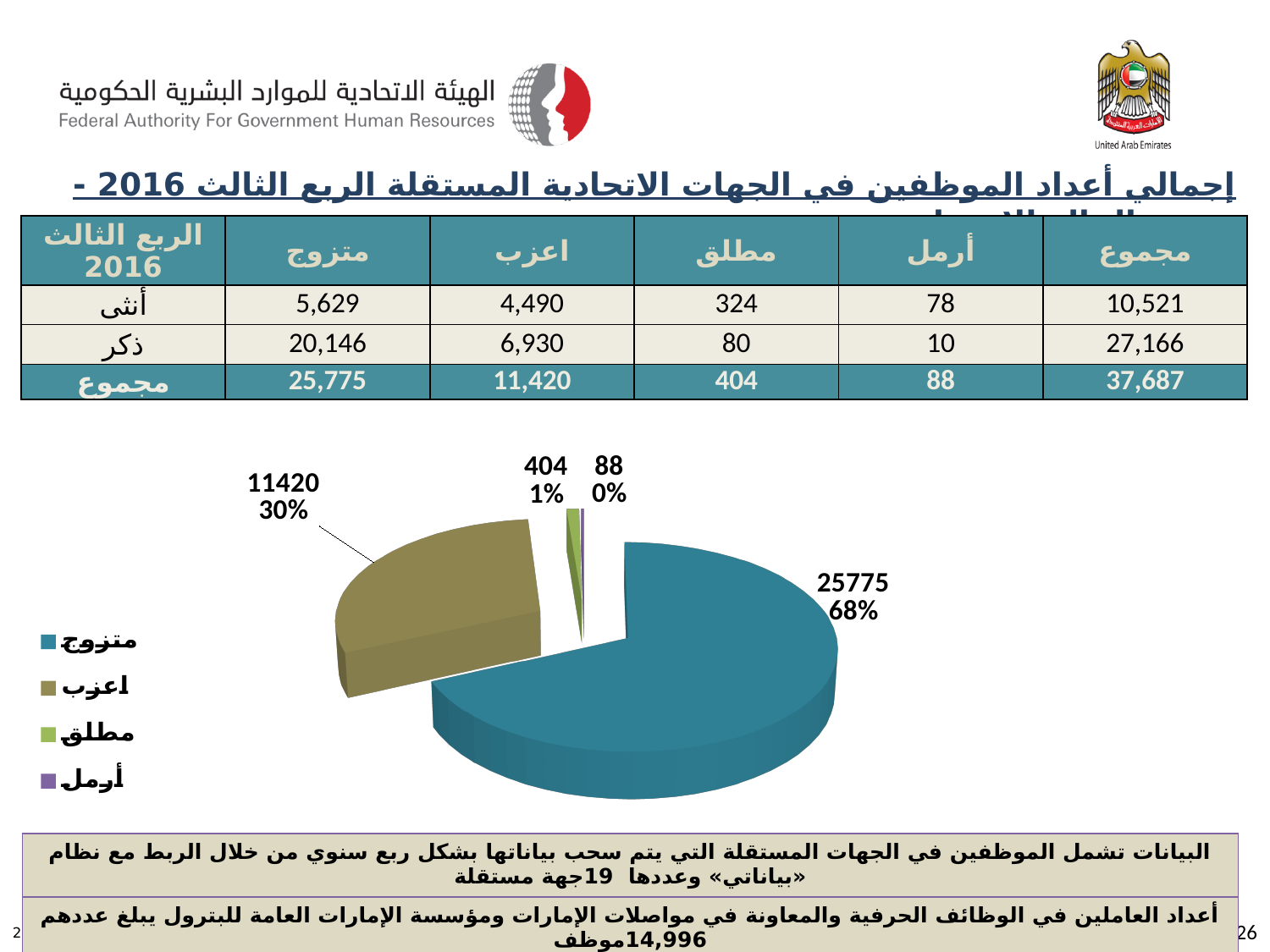
Which category has the smallest slice in the pie chart? أرمل What percentage share is shown for the متزوج slice of the pie chart? 68% What value is labelled on the مطلق slice of the pie chart? 404 What value is labelled on the largest slice of the pie chart (متزوج)? 25775 What type of chart is shown on the slide? Pie chart Which category has the largest slice in the pie chart? متزوج How many slices does the pie chart have? 4 How many entries does the pie chart's legend list? 4 What is the difference between the متزوج value and the اعزب value in the pie chart? 14355 What value is labelled on the اعزب slice of the pie chart? 11420 What percentage share is shown for the أرمل slice of the pie chart? 0% What percentage share is shown for the اعزب slice of the pie chart? 30%